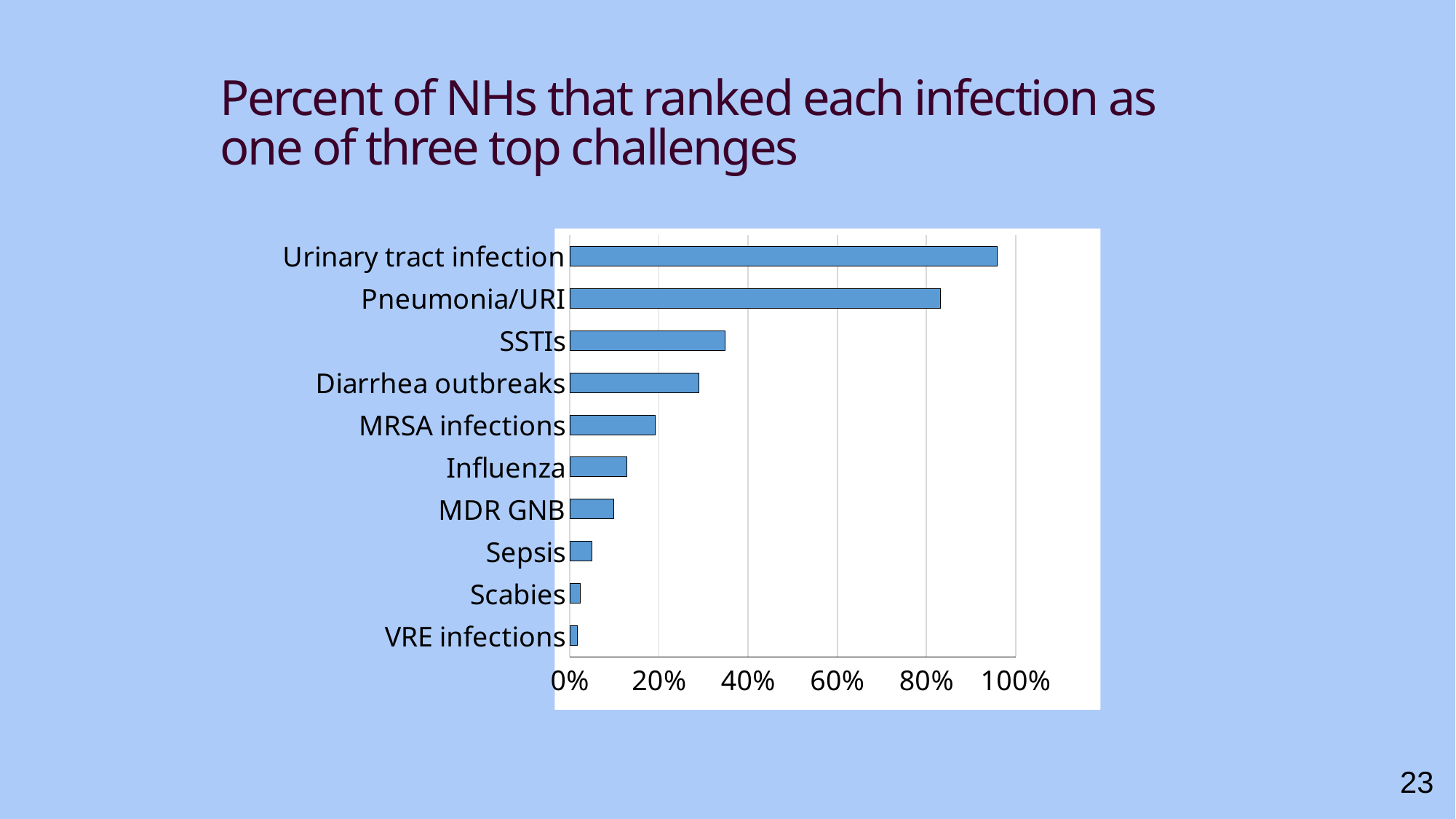
Is the value for Urinary tract infection greater or less than 80%? greater Is the value for Diarrhea outbreaks greater or less than 20%? greater What kind of chart is shown on the slide? bar chart Which is larger, the value for Influenza or the value for MDR GNB? Influenza Which is larger, the value for SSTIs or the value for Diarrhea outbreaks? SSTIs Is the value for SSTIs greater or less than 40%? less How many infection categories are plotted in the chart? 10 Which infection has the highest percentage of NHs ranking it as a top-three challenge? Urinary tract infection What is the title of the chart on the slide? Percent of NHs that ranked each infection as one of three top challenges